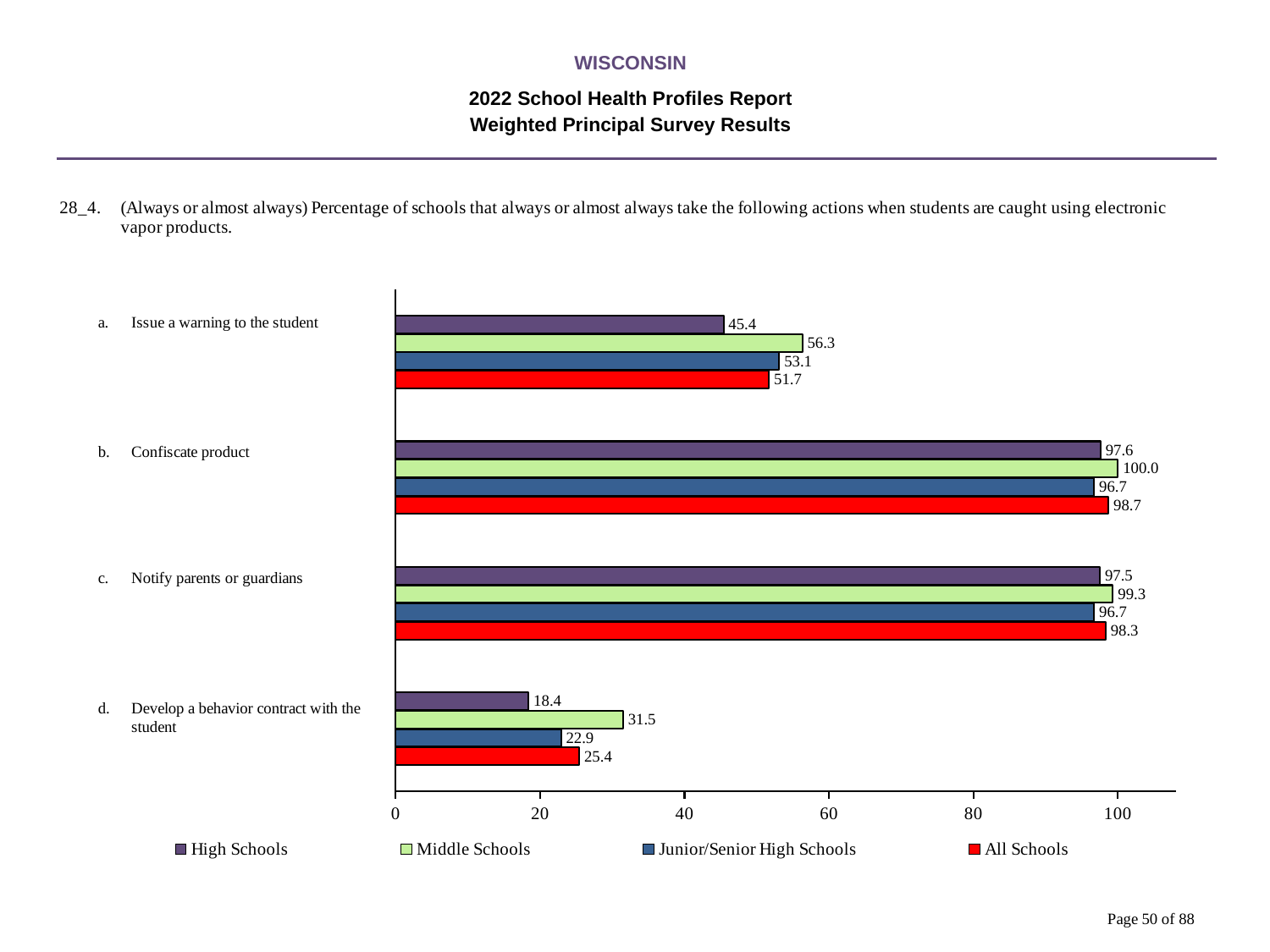
How many categories (actions) are shown on the chart? 4 What is the difference between the Middle Schools and High Schools values for 'Develop a behavior contract with the student'? 13.1 What is the value for Junior/Senior High Schools for 'Notify parents or guardians'? 96.7 Which category has the highest value for Middle Schools? Confiscate product Is the All Schools value for 'Issue a warning to the student' greater or less than 60? less Which category has the lowest value for High Schools? Develop a behavior contract with the student What is the value for Middle Schools for 'Confiscate product'? 100.0 What is the value for All Schools for 'Develop a behavior contract with the student'? 25.4 How many series does the legend list? 4 What is the value for High Schools for 'Issue a warning to the student'? 45.4 Which is larger for 'Issue a warning to the student': the Middle Schools value or the Junior/Senior High Schools value? Middle Schools What kind of chart is shown on the slide? Bar chart